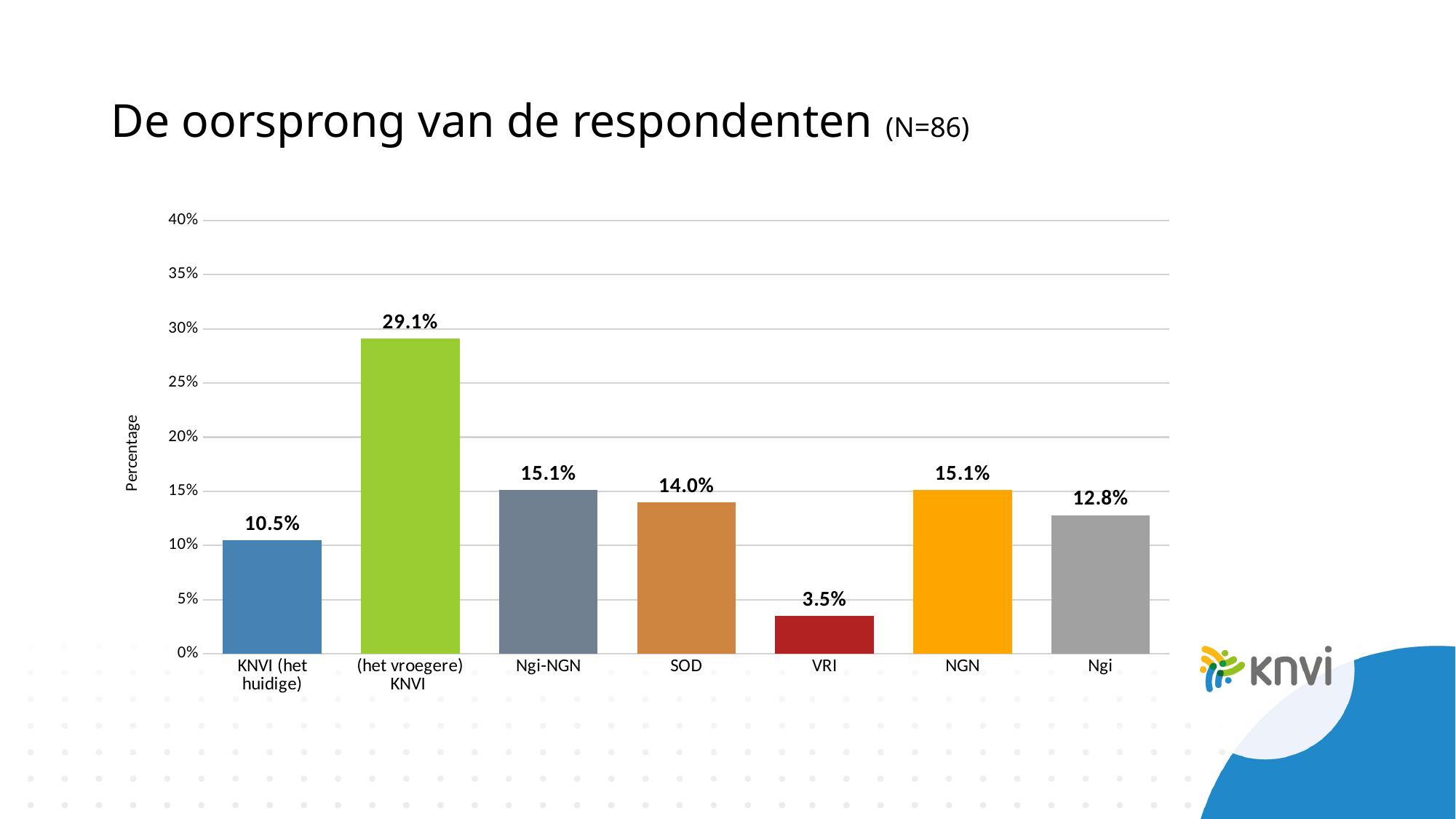
How many categories are shown on the x axis? 7 What kind of chart is shown on the slide? Bar chart What is the label of the y axis? Percentage What percentage of respondents come from (het vroegere) KNVI? 29.1% What is the difference between the values for (het vroegere) KNVI and Ngi? 16.3% Which category has the lowest percentage? VRI What is the title of the slide? De oorsprong van de respondenten (N=86) What is the value shown for VRI? 3.5% Which category has the highest percentage? (het vroegere) KNVI What percentage is shown for SOD? 14.0% Which is larger, the value for SOD or the value for Ngi? SOD What is the value for KNVI (het huidige)? 10.5%